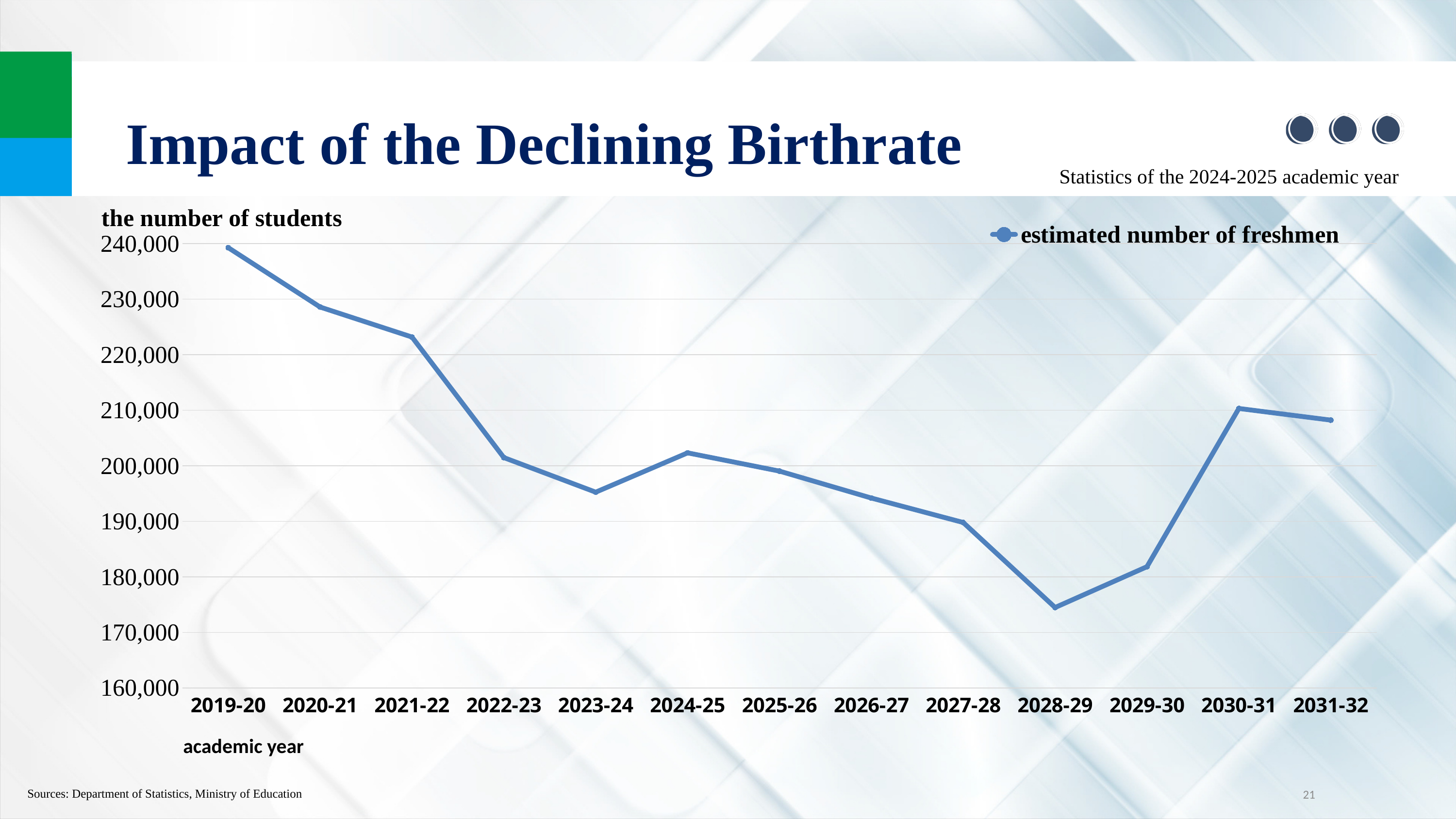
What is the label of the series shown in the legend? estimated number of freshmen What kind of chart is shown on the slide? line chart Is the estimated number of freshmen for 2019-20 greater or less than 230,000? greater How many academic years are plotted on the x axis? 13 Which academic year has the lowest estimated number of freshmen? 2028-29 Which is larger, the estimated number of freshmen for 2020-21 or for 2021-22? 2020-21 Is the estimated number of freshmen for 2023-24 greater or less than 200,000? less Is the estimated number of freshmen for 2030-31 greater or less than 200,000? greater How many series does the legend list? 1 Does the estimated number of freshmen rise or fall from 2019-20 to 2028-29? fall Which academic year has the highest estimated number of freshmen? 2019-20